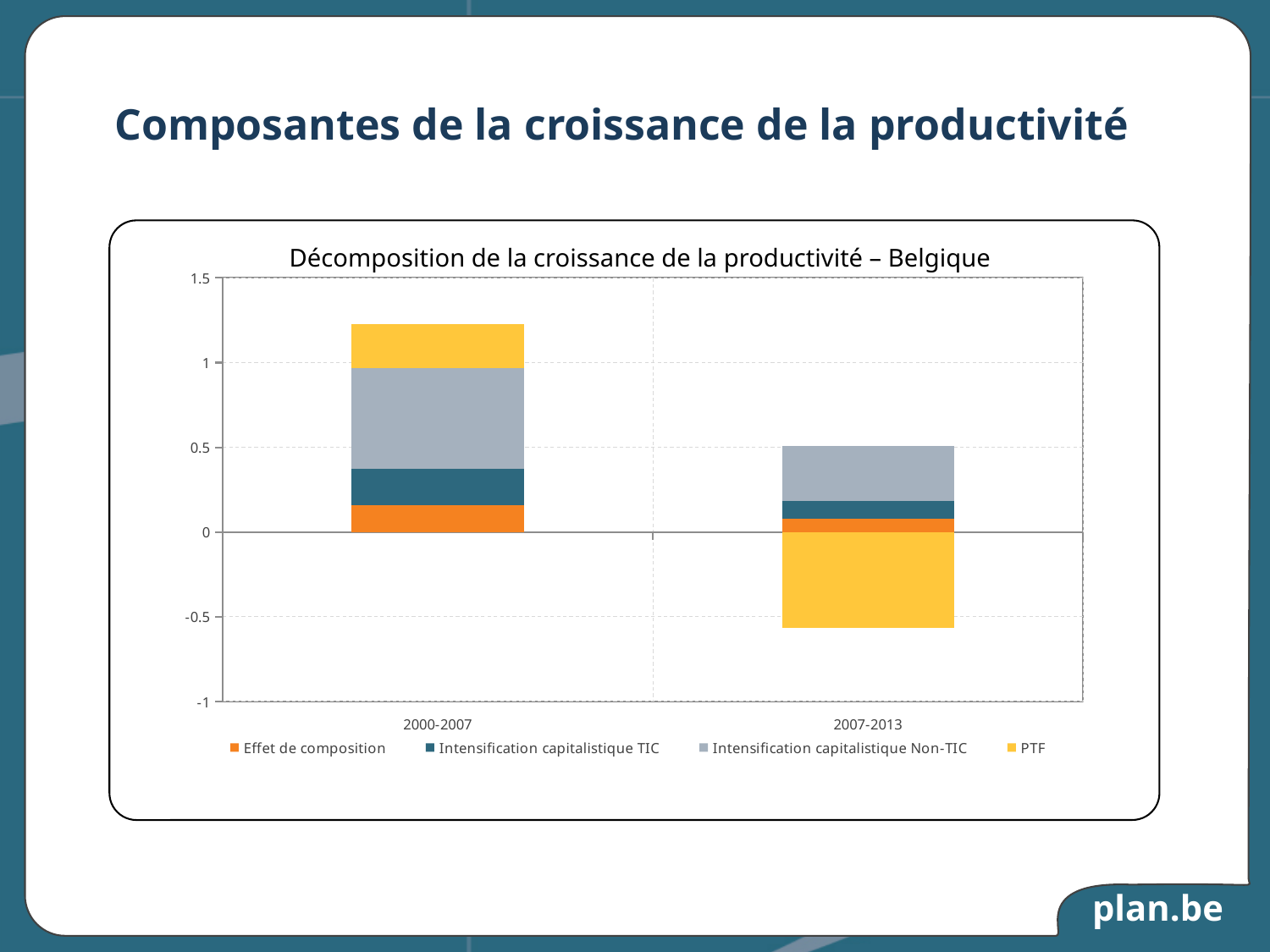
Is the Intensification capitalistique Non-TIC value for 2000-2007 greater or less than 0.5? greater What kind of chart is shown on the slide? Stacked bar chart Which period has the larger PTF value, 2000-2007 or 2007-2013? 2000-2007 Which series is shown in yellow in the legend? PTF How many time periods (categories) are shown on the x axis? 2 Which period has the larger Intensification capitalistique Non-TIC value, 2000-2007 or 2007-2013? 2000-2007 What is the title of the chart? Décomposition de la croissance de la productivité – Belgique Is the PTF value for 2007-2013 greater or less than 0? less Which period has the larger Intensification capitalistique TIC value, 2000-2007 or 2007-2013? 2000-2007 Is the top of the stacked bar for 2000-2007 greater or less than 1? greater How many series does the legend list? 4 Which series is the only one with a negative value in the chart? PTF